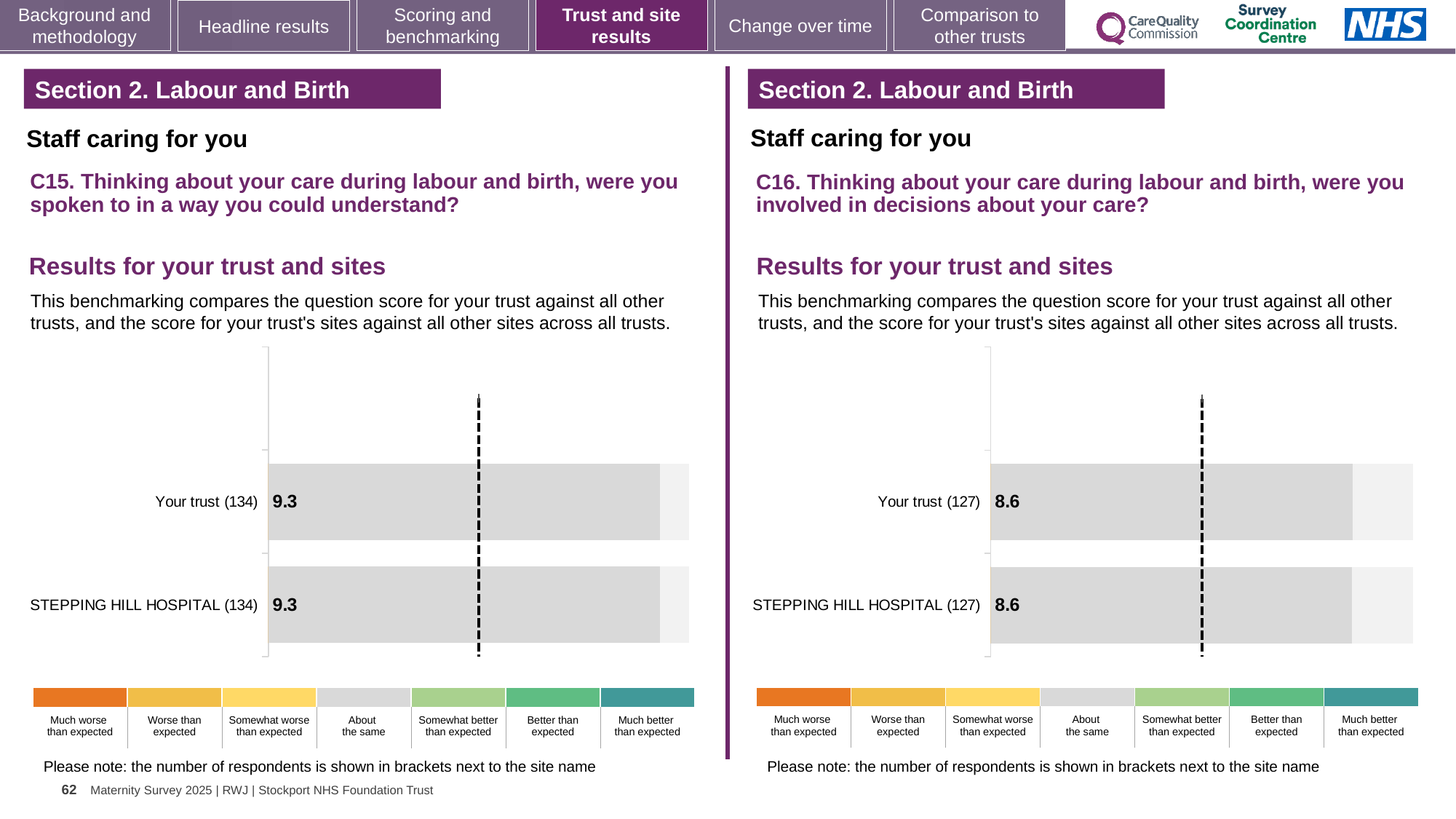
How many bars are plotted on the C15 chart (left)? 2 On the C16 chart (right), what is the difference between the Your trust score and the STEPPING HILL HOSPITAL score? 0 On the C15 chart (left), what is the score for Your trust? 9.3 On the C15 chart (left), what is the difference between the Your trust score and the STEPPING HILL HOSPITAL score? 0 On the C16 chart (right), what is the score for STEPPING HILL HOSPITAL? 8.6 On the C15 chart (left), what is the score for STEPPING HILL HOSPITAL? 9.3 Is the Your trust score on the C15 chart (left) larger than the Your trust score on the C16 chart (right)? Yes On the C16 chart (right), how many respondents are shown in brackets next to Your trust? 127 On the C16 chart (right), what is the score for Your trust? 8.6 How many bars are plotted on the C16 chart (right)? 2 What kind of chart is used on the C15 chart (left)? Bar chart On the C15 chart (left), how many respondents are shown in brackets next to STEPPING HILL HOSPITAL? 134